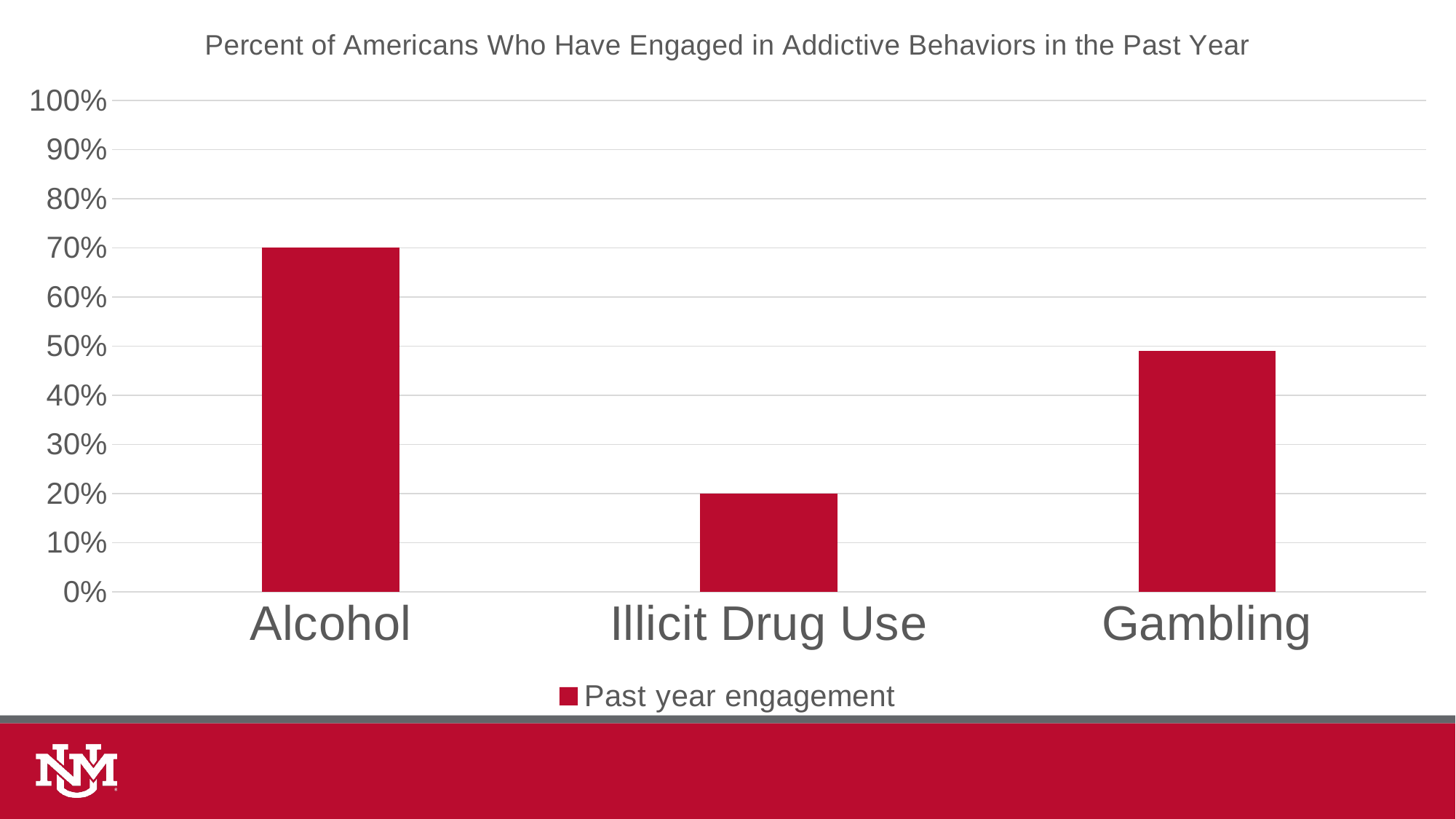
Which is larger, the value for Gambling or the value for Illicit Drug Use? Gambling How many series does the legend list? 1 What is the title of the chart? Percent of Americans Who Have Engaged in Addictive Behaviors in the Past Year What is the value for Alcohol? 70% What is the value for Illicit Drug Use? 20% Is the value for Gambling greater or less than 40%? greater Which category has the lowest value? Illicit Drug Use Which category has the highest value? Alcohol How many categories are shown on the x axis? 3 What is the difference between the values for Alcohol and Illicit Drug Use? 50% What is the name of the series shown in the legend? Past year engagement What type of chart is shown on the slide? bar chart